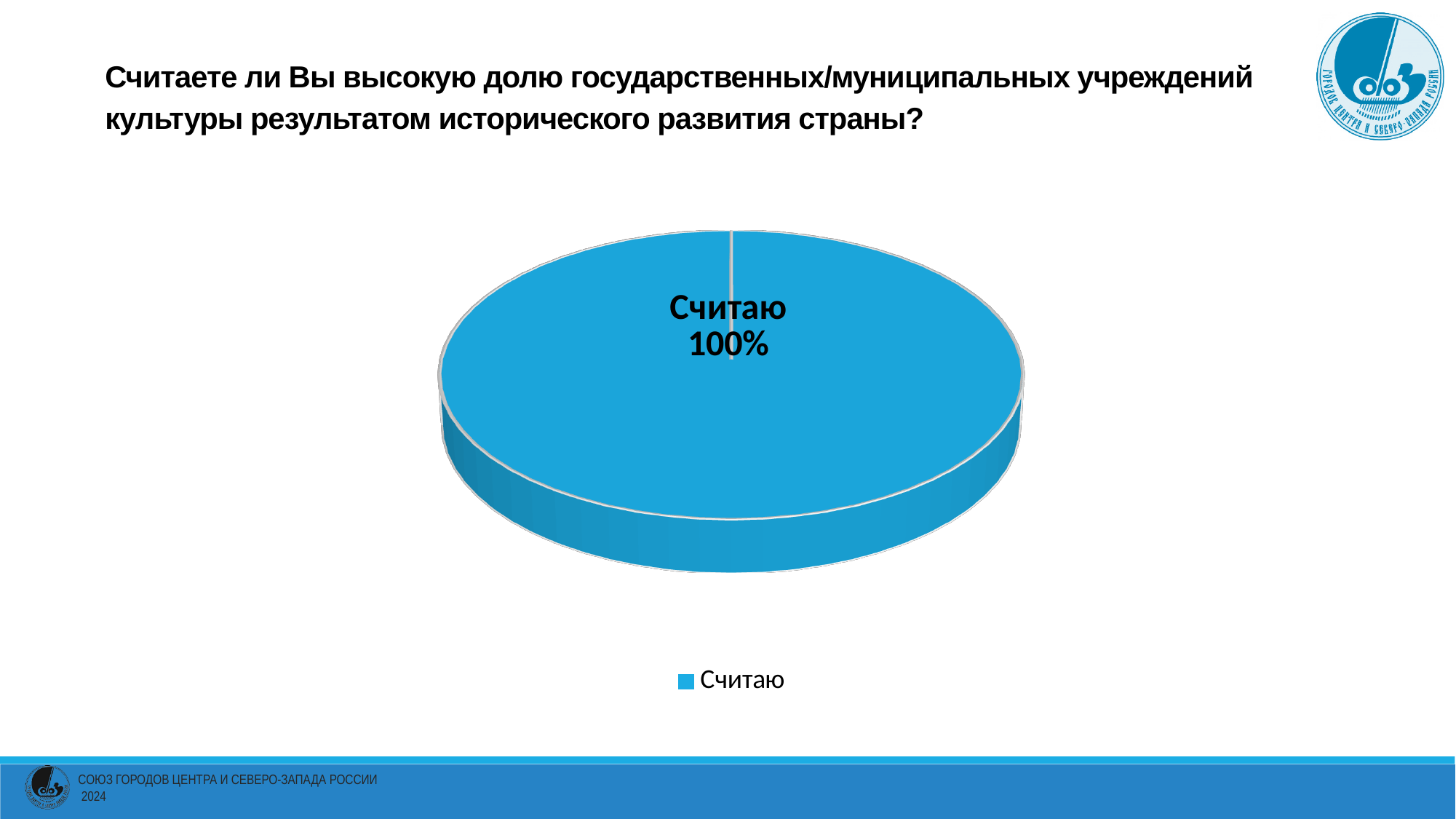
What is the label of the only category in the legend? Считаю What share of the pie does the "Считаю" slice represent? 100% What kind of chart is shown on the slide? pie chart What colour is the "Считаю" slice? blue Is the value for "Считаю" greater or less than 50%? greater How many slices does the pie chart have? 1 How many entries does the legend list? 1 What is the value shown for the "Считаю" category? 100%